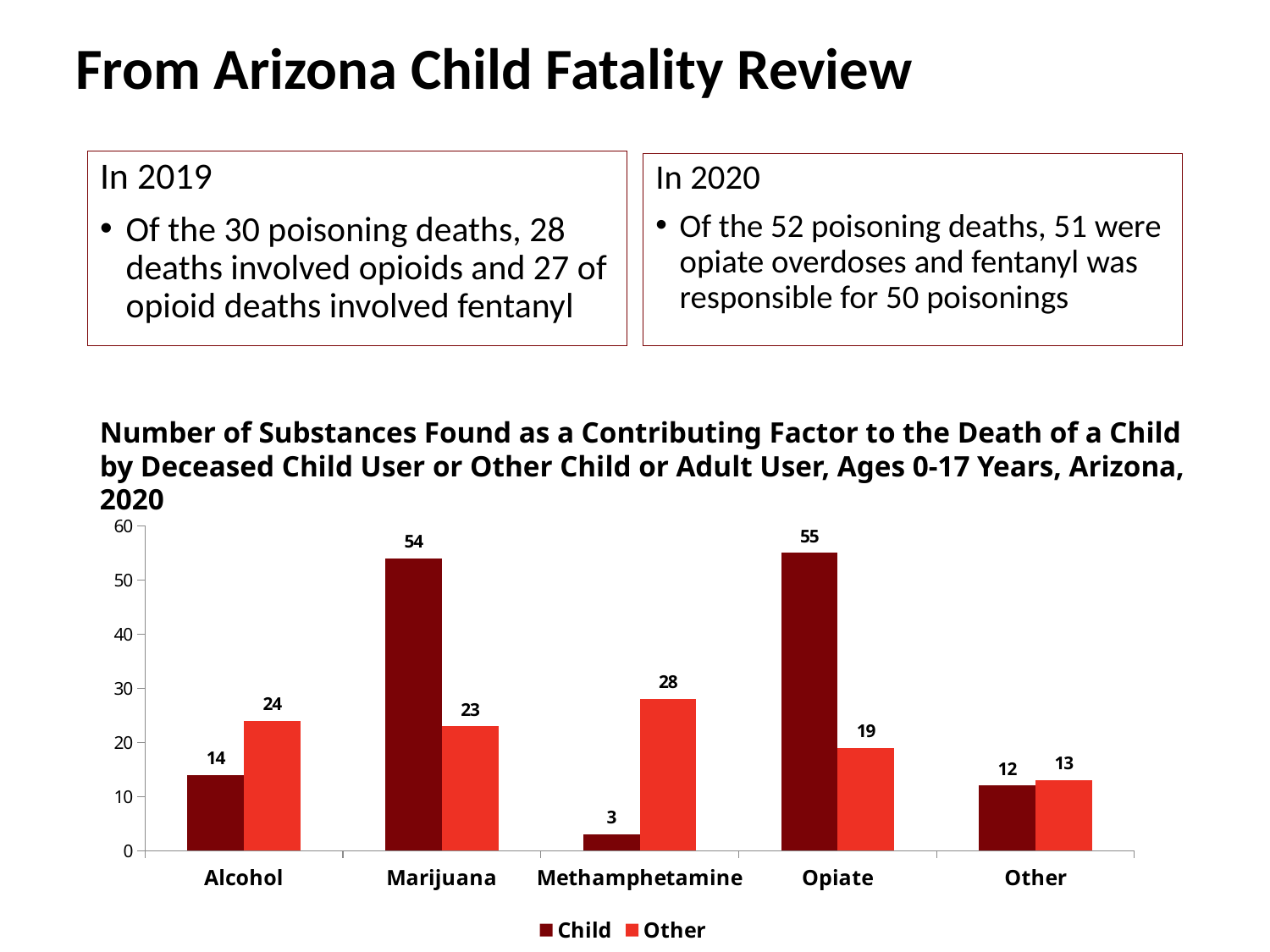
How many series does the legend list? 2 What is the Child value for Marijuana? 54 What colour are the Child bars? Dark red How many substance categories are shown on the x axis? 5 What kind of chart is shown on the slide? Bar chart What is the difference between the Child and Other values for Opiate? 36 What is the Other value for Methamphetamine? 28 Which category has the highest Other value? Methamphetamine Which category has the lowest Child value? Methamphetamine What is the Child value for Opiate? 55 Which category has the highest Child value? Opiate Which is larger for Alcohol, the Child value or the Other value? Other